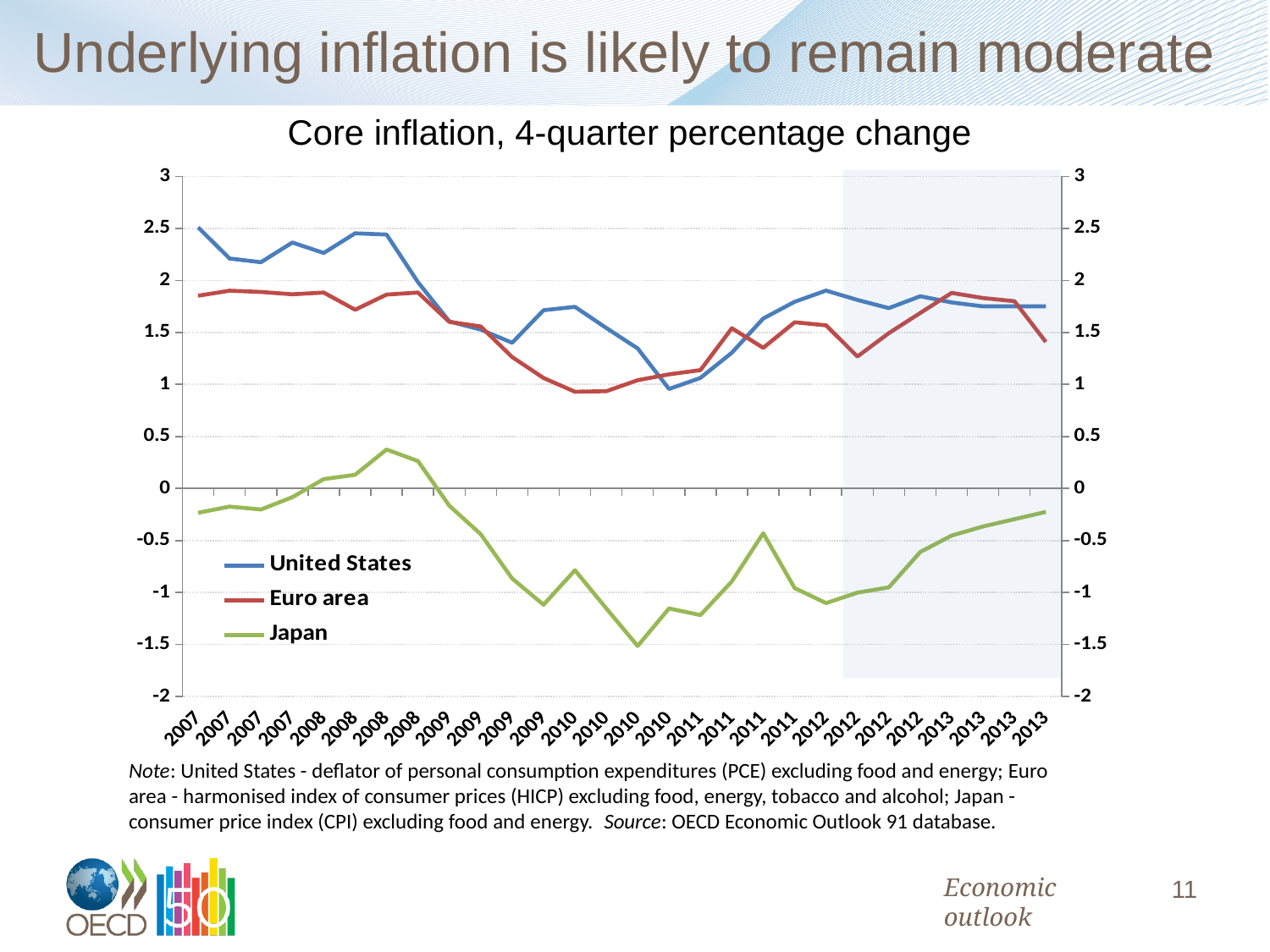
Is the value for the United States at the first 2007 point greater or less than 2? greater Is the lowest value for Japan (in 2010) greater or less than -1? less What kind of chart is shown on the slide? line chart How many series does the legend list? 3 What is the title of the chart? Core inflation, 4-quarter percentage change Is the value for Japan at the last 2013 point greater or less than 0? less How many distinct years are labelled on the x axis? 7 Does the United States line rise or fall from the start of 2007 to the end of 2009? fall Which series has the lowest values throughout the chart? Japan Which colour is used for the Japan line? green Which is larger at the last 2013 point, the United States or the Euro area? United States